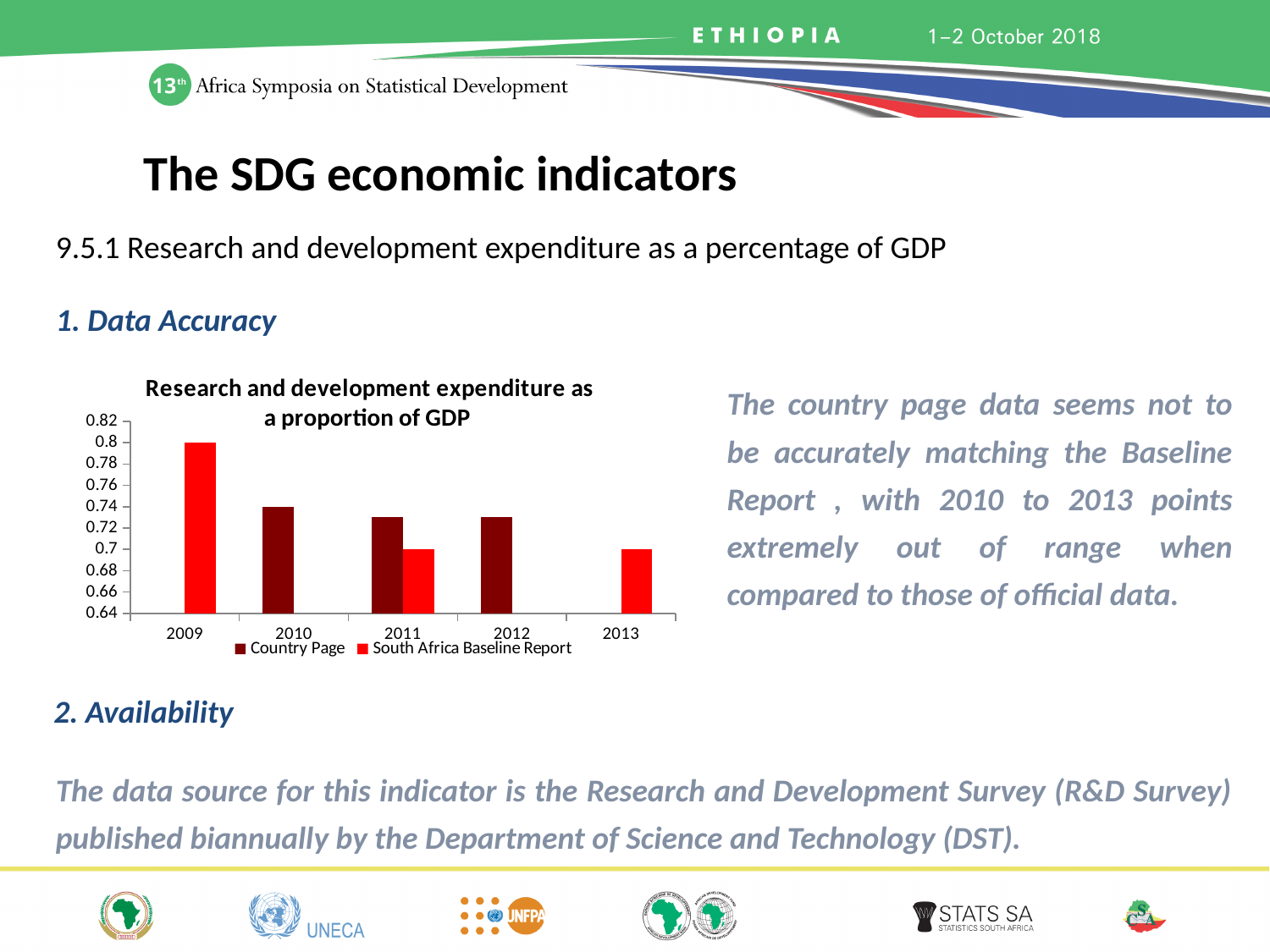
What is the South Africa Baseline Report value for 2013? 0.7 What is the Country Page value for 2010? 0.74 How many years are shown on the x axis of the chart? 5 In 2011, which series has the larger value, Country Page or South Africa Baseline Report? Country Page Which years have no Country Page bar in the chart? 2009 and 2013 Is the Country Page value for 2012 greater or less than 0.74? less What kind of chart is shown on the slide? Bar chart How many series does the legend of the chart list? 2 What is the difference between the South Africa Baseline Report values for 2009 and 2013? 0.1 Is the Country Page value for 2011 greater or less than 0.7? greater Which bar is the highest in the chart? South Africa Baseline Report, 2009 What is the South Africa Baseline Report value for 2009? 0.8